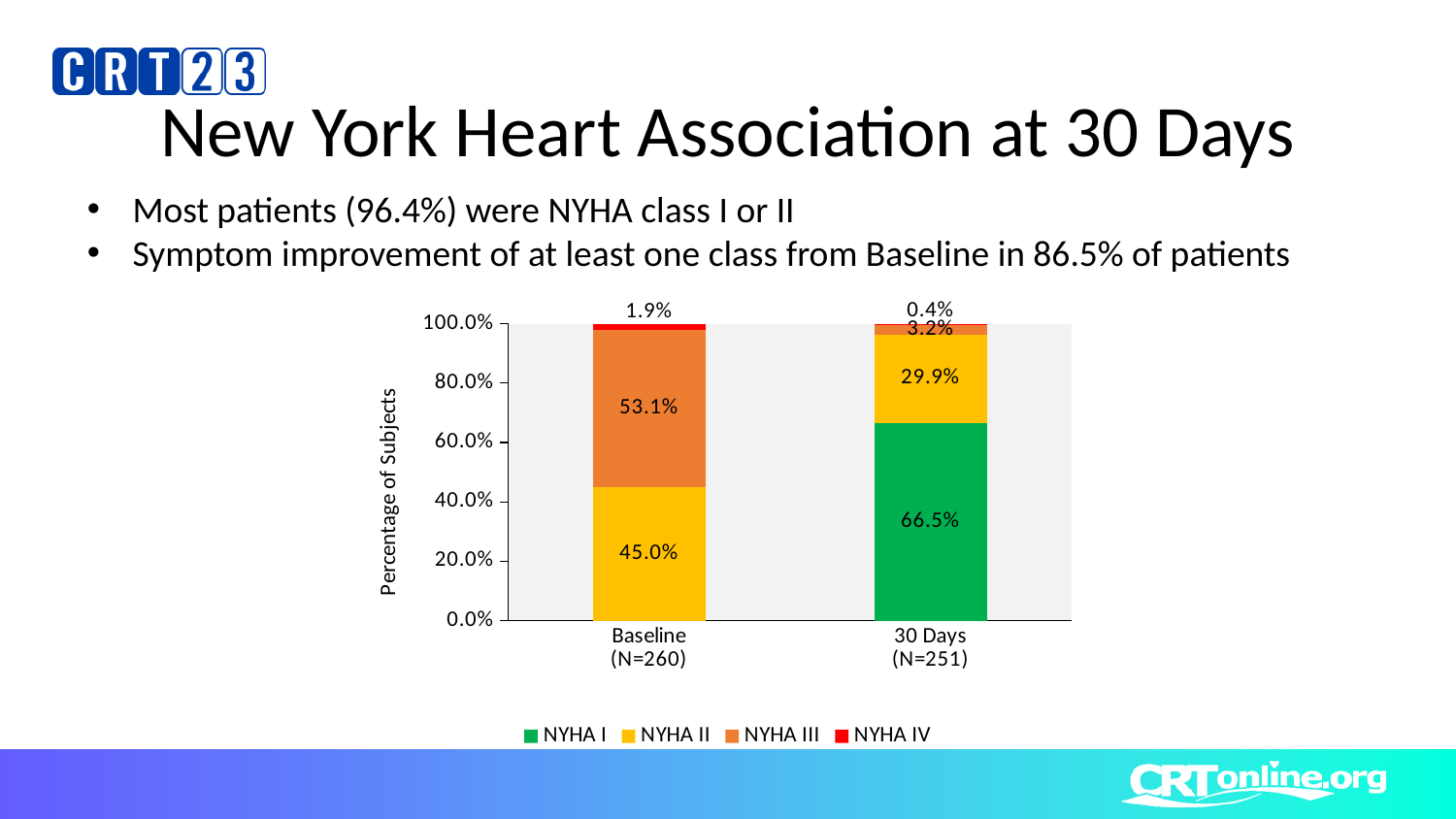
What percentage of subjects were NYHA IV at Baseline? 1.9% What kind of chart is shown? Stacked bar chart What percentage of subjects were NYHA II at 30 Days? 29.9% What is the difference between the NYHA III percentage at Baseline and at 30 Days? 49.9% What percentage of subjects were NYHA I at 30 Days? 66.5% What percentage of subjects were NYHA III at Baseline? 53.1% Which is larger: the NYHA II percentage at Baseline or at 30 Days? Baseline What percentage of subjects were NYHA IV at 30 Days? 0.4% What percentage of subjects were NYHA III at 30 Days? 3.2% What is the label of the y axis? Percentage of Subjects What percentage of subjects were NYHA II at Baseline? 45.0% How many series does the legend list? 4